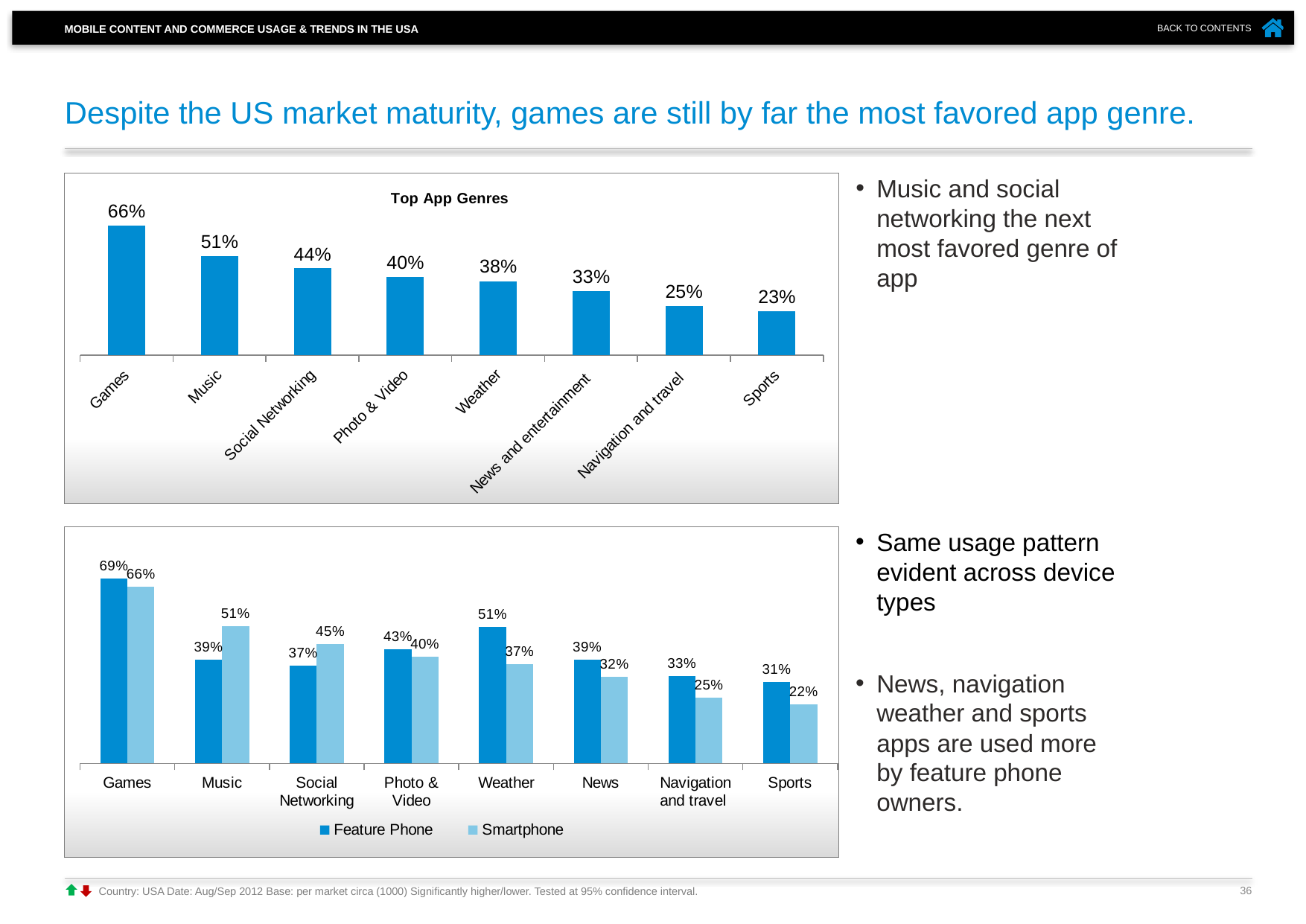
In the bottom chart, how many series does the legend list? 2 In the bottom chart, what is the Smartphone value for Music? 51% In the 'Top App Genres' chart, which category has the lowest value? Sports In the bottom chart, which series is shown in the lighter blue colour? Smartphone In the bottom chart, what is the Feature Phone value for Weather? 51% In the bottom chart, which is larger for Sports: Feature Phone or Smartphone? Feature Phone In the 'Top App Genres' chart, what is the value for Navigation and travel? 25% In the 'Top App Genres' chart, what is the value for Games? 66% In the 'Top App Genres' chart, what is the difference between Music and Social Networking? 7% In the bottom chart, what is the difference between the Feature Phone and Smartphone values for Weather? 14% In the 'Top App Genres' chart, how many categories are shown? 8 What type of chart is the bottom chart? Bar chart